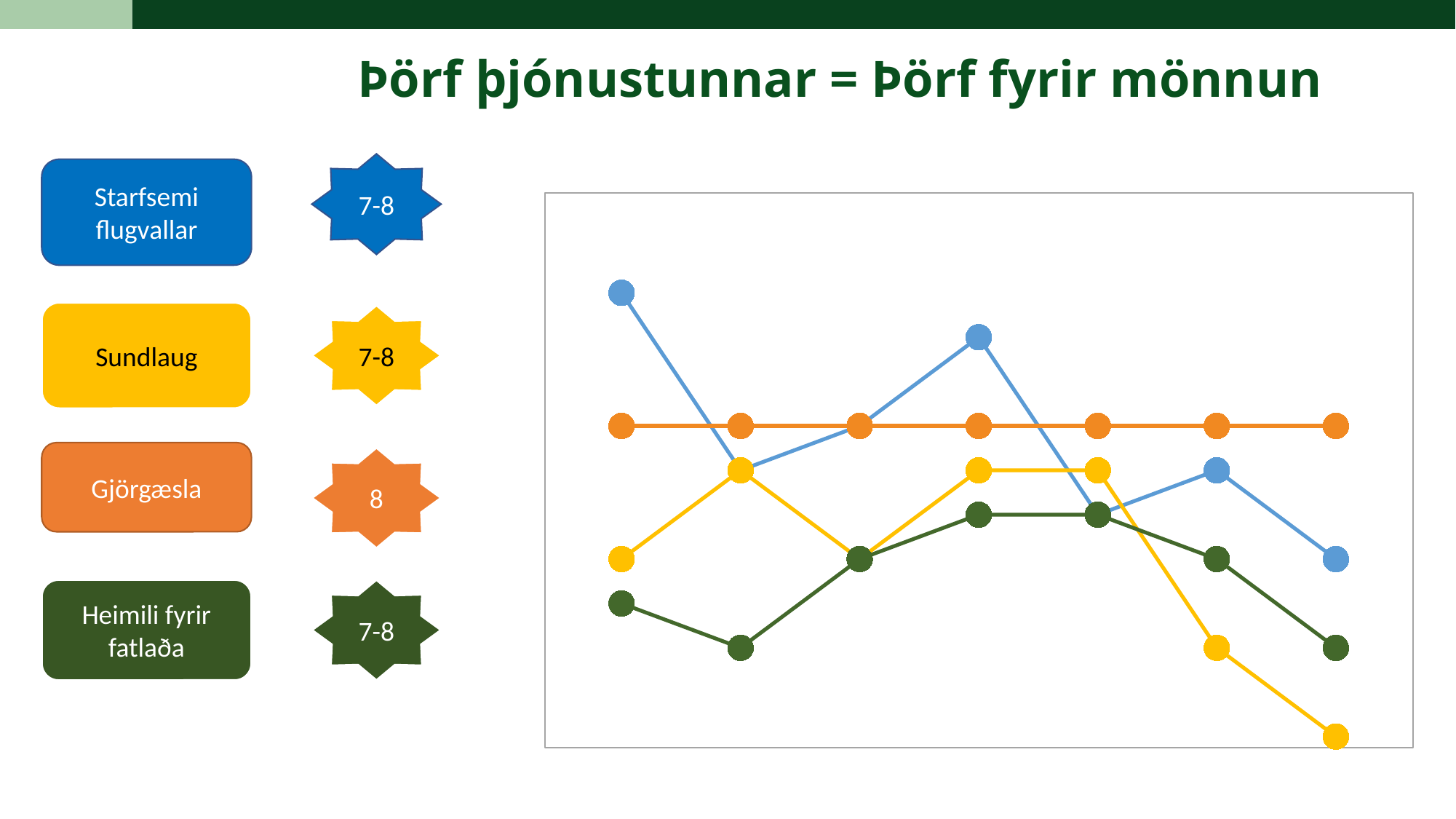
Which coloured line is highest at the first point of the chart? blue What kind of chart is shown on the slide? line chart At the second point, is the yellow line above or below the orange line? below Does the yellow line rise or fall from the fifth point to the seventh point? fall Which coloured line is highest at the fourth point of the chart? blue How many lines are plotted in the chart? 4 How many data points does each line in the chart have? 7 At the first point, is the blue line higher or lower than the green line? higher Which coloured line is lowest at the first point of the chart? green Does the blue line rise or fall from the first point to the second point? fall Which coloured line is lowest at the last point of the chart? yellow Does the orange line rise, fall, or stay flat across the chart? stays flat